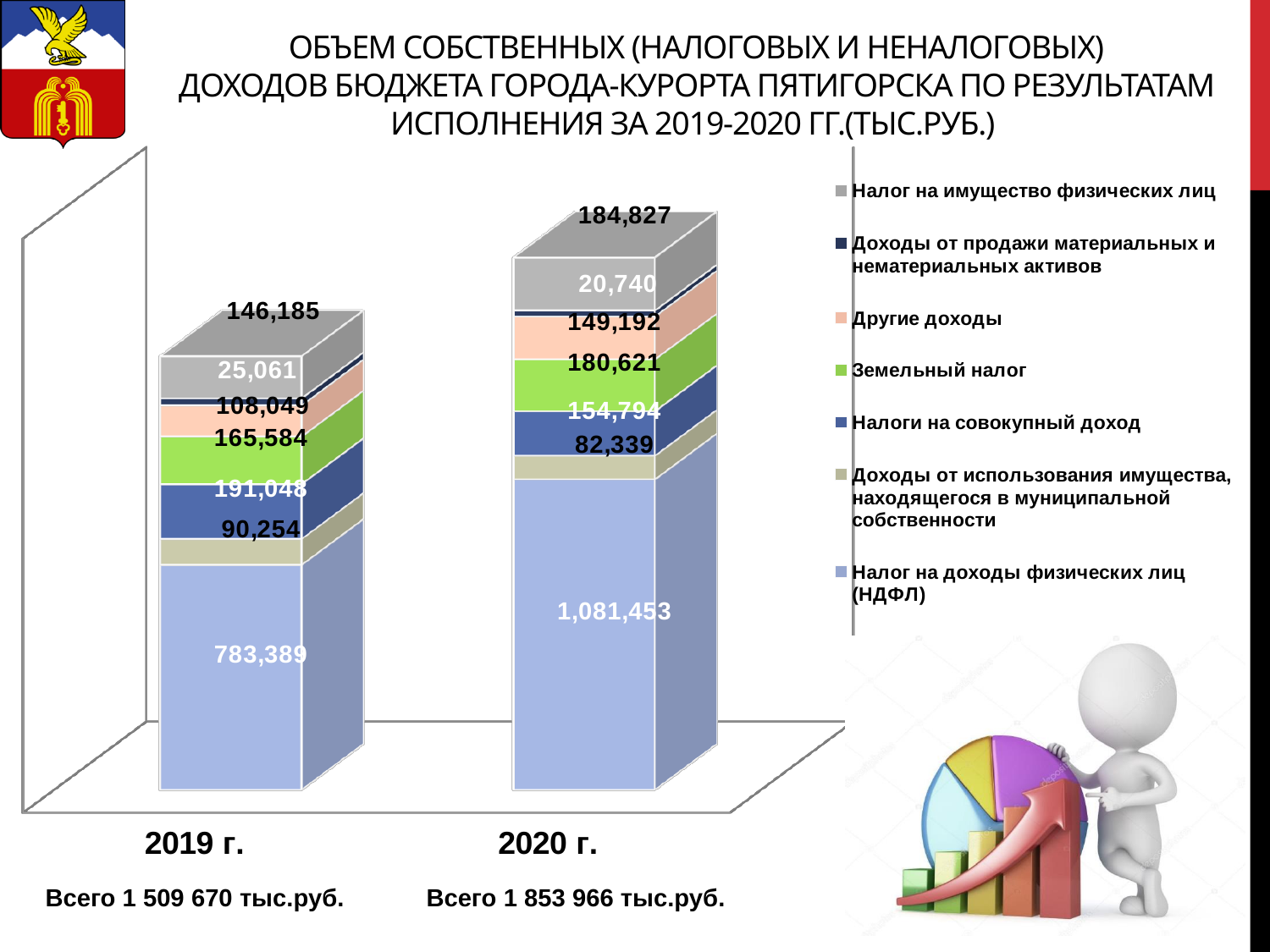
What is the value of Налоги на совокупный доход for 2020 г.? 154,794 What is the value of Налог на доходы физических лиц (НДФЛ) for 2020 г.? 1,081,453 What is the value of Налог на имущество физических лиц for 2020 г.? 184,827 Which series has the smallest value in the 2020 г. bar? Доходы от продажи материальных и нематериальных активов How many series does the legend list? 7 Which series has the largest value in the 2019 г. bar? Налог на доходы физических лиц (НДФЛ) What is the value of Земельный налог for 2019 г.? 165,584 What is the value of Доходы от продажи материальных и нематериальных активов for 2019 г.? 25,061 Which is larger: Другие доходы in 2019 г. or in 2020 г.? 2020 г. What total is shown for the 2020 г. bar? 1 853 966 тыс.руб. What kind of chart is shown on the slide? Stacked bar chart By how much did Налог на доходы физических лиц (НДФЛ) increase from 2019 г. to 2020 г.? 298,064